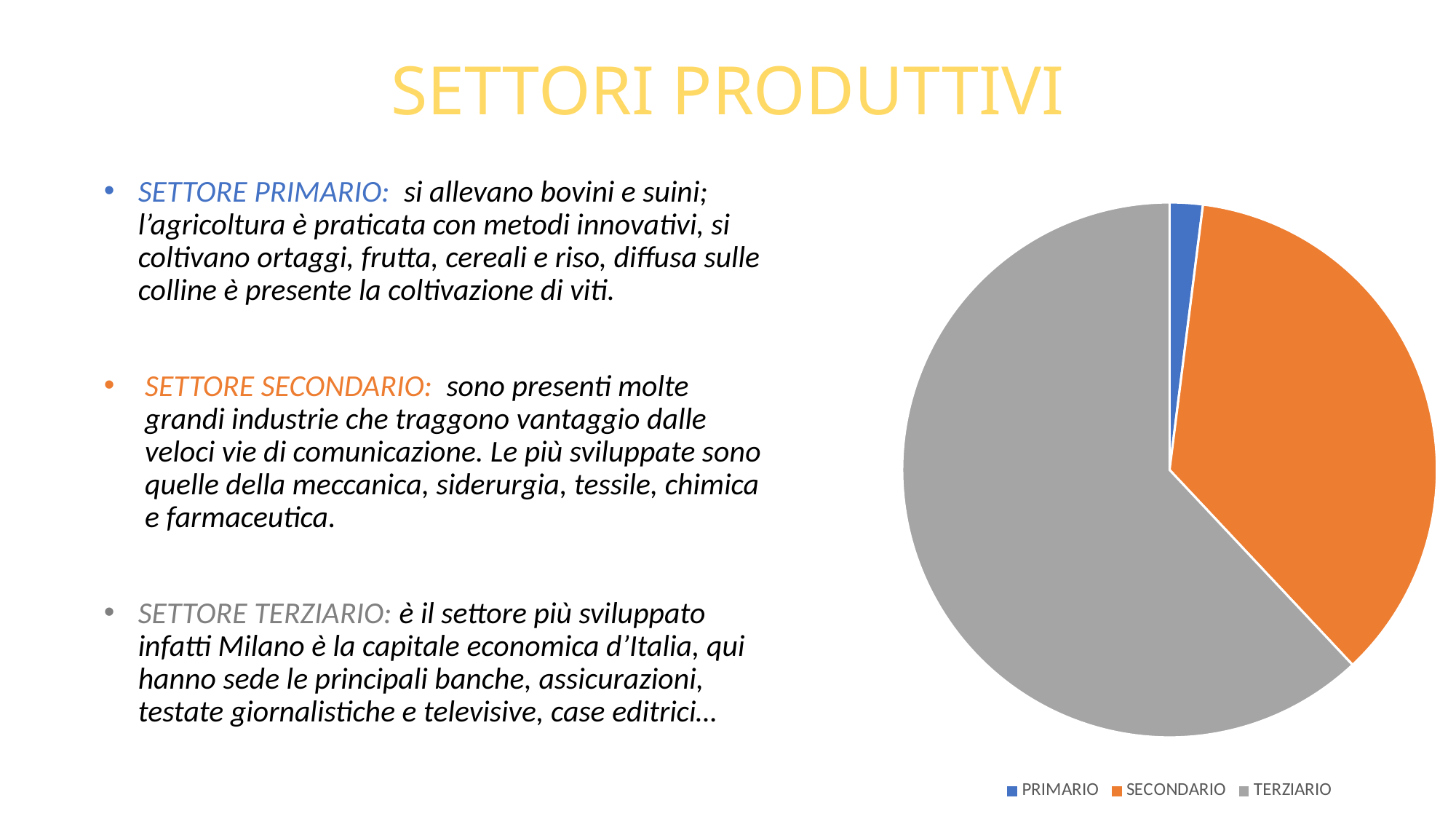
Which sector has the smallest slice in the pie chart? PRIMARIO How many entries does the legend of the pie chart list? 3 Which slice is larger in the pie chart, SECONDARIO or PRIMARIO? SECONDARIO Which legend entry of the pie chart is shown in orange? SECONDARIO Which sector has the largest slice in the pie chart? TERZIARIO What colour is the TERZIARIO slice in the pie chart? grey What kind of chart is shown on the slide? pie chart How many slices does the pie chart have? 3 Which slice is larger in the pie chart, TERZIARIO or SECONDARIO? TERZIARIO